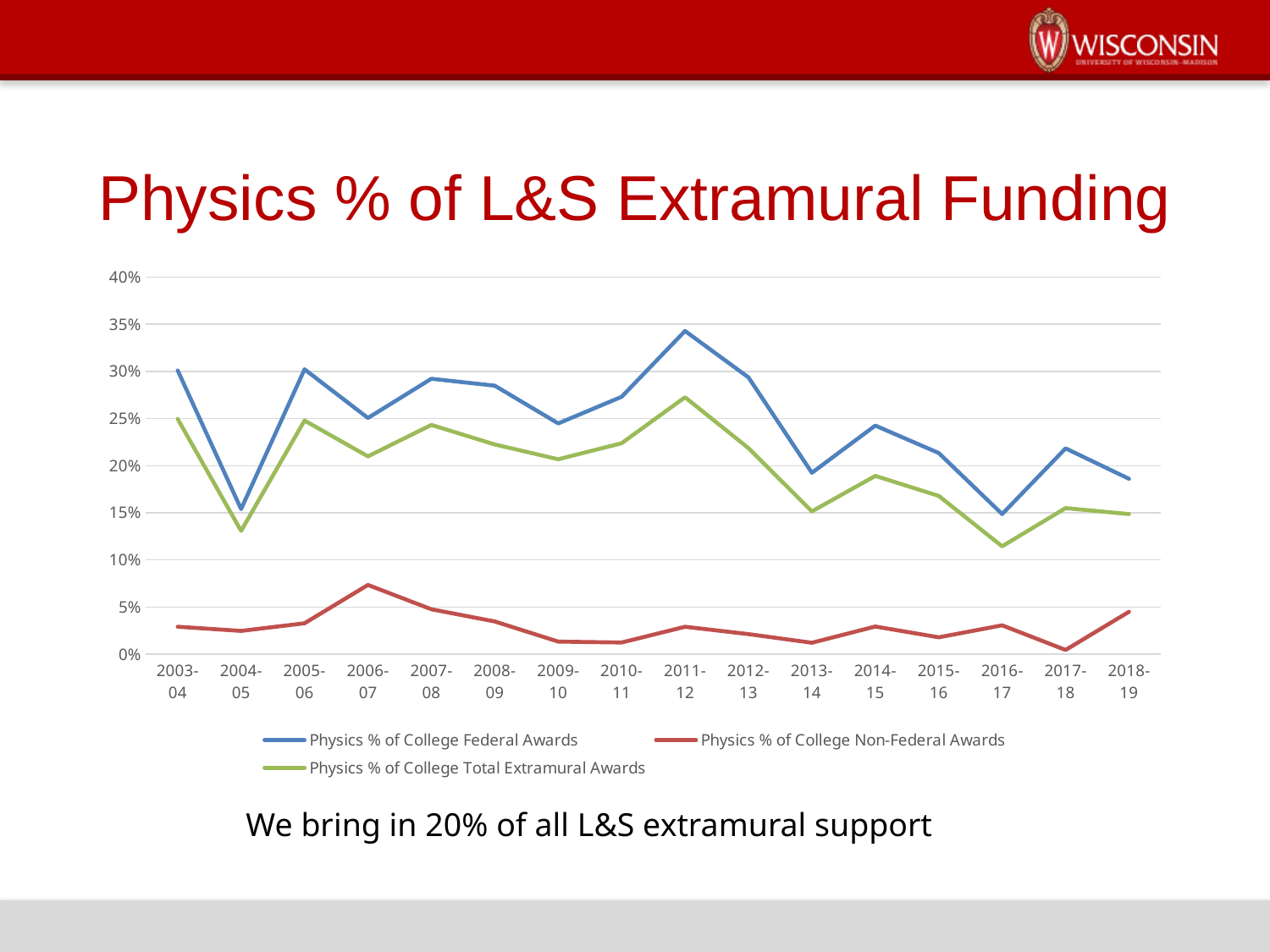
In which year does Physics % of College Federal Awards reach its highest value? 2011-12 Which is larger in 2003-04: Physics % of College Federal Awards or Physics % of College Total Extramural Awards? Physics % of College Federal Awards What kind of chart is shown on the slide? line chart In which year is Physics % of College Non-Federal Awards at its lowest? 2017-18 How many academic years are plotted along the x axis? 16 Is the value for Physics % of College Federal Awards in 2011-12 greater or less than 30%? greater Is the value for Physics % of College Non-Federal Awards in 2006-07 greater or less than 5%? greater Is the value for Physics % of College Total Extramural Awards in 2016-17 greater or less than 15%? less Does Physics % of College Federal Awards rise or fall from 2011-12 to 2013-14? fall In which year does Physics % of College Total Extramural Awards reach its highest value? 2011-12 In which year does Physics % of College Non-Federal Awards reach its highest value? 2006-07 How many series does the legend list? 3